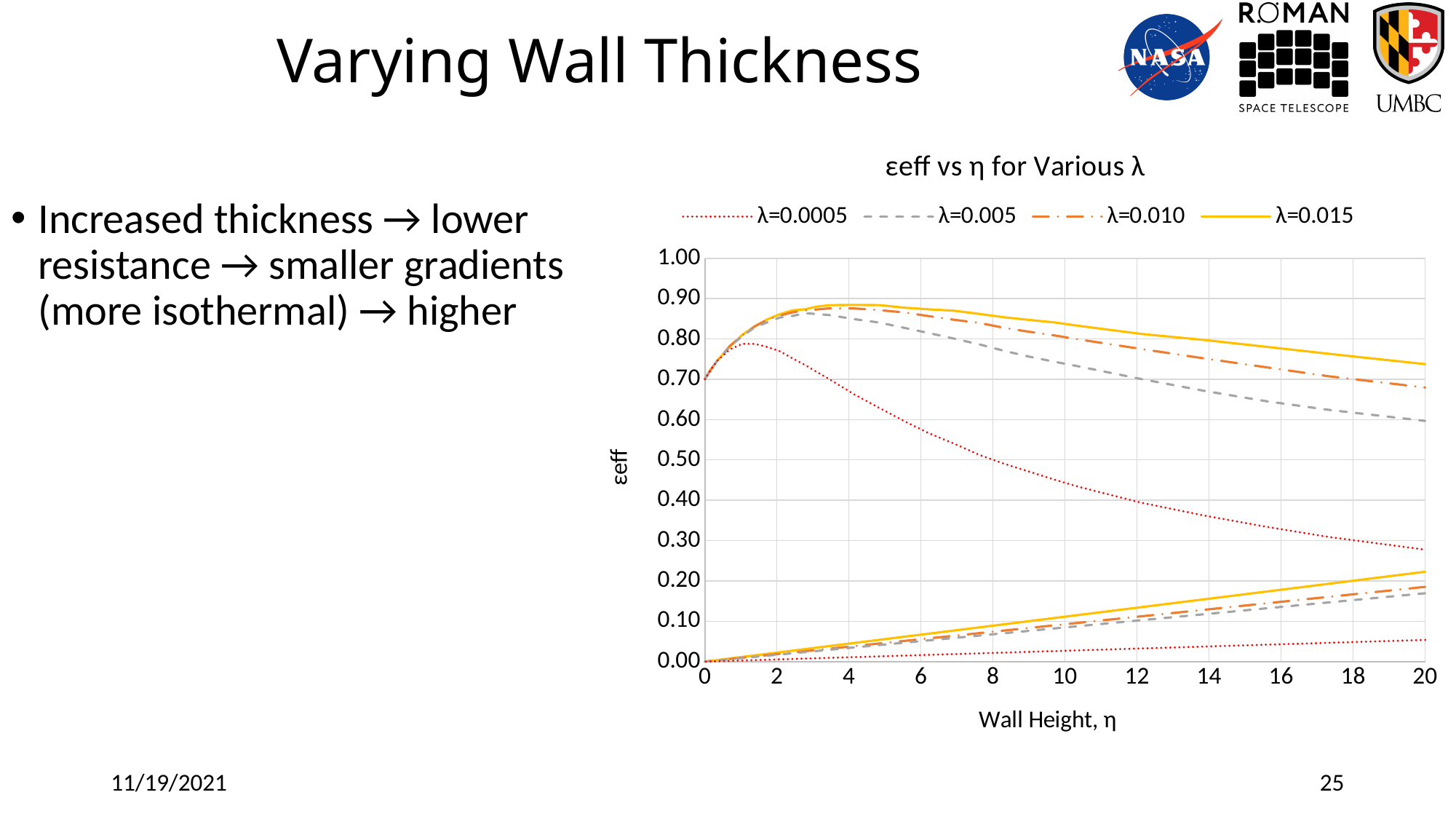
What is the title of the chart? εeff vs η for Various λ Which series has the lowest upper curve at η=20? λ=0.0005 Is the value of the upper λ=0.0005 curve at η=20 greater or less than 0.50? less Is the value of the upper λ=0.010 curve at η=20 greater or less than 0.80? less How many series does the legend list? 4 Does the upper λ=0.0005 curve rise or fall between η=4 and η=20? fall At η=0, what εeff value do the upper curves start from? 0.70 What is the label of the x axis? Wall Height, η Is the value of the upper λ=0.015 curve at η=20 greater or less than 0.60? greater What kind of chart is shown on the slide? line chart At η=20, which upper curve is higher: λ=0.015 or λ=0.0005? λ=0.015 At η=0, what εeff value do the lower curves start from? 0.00